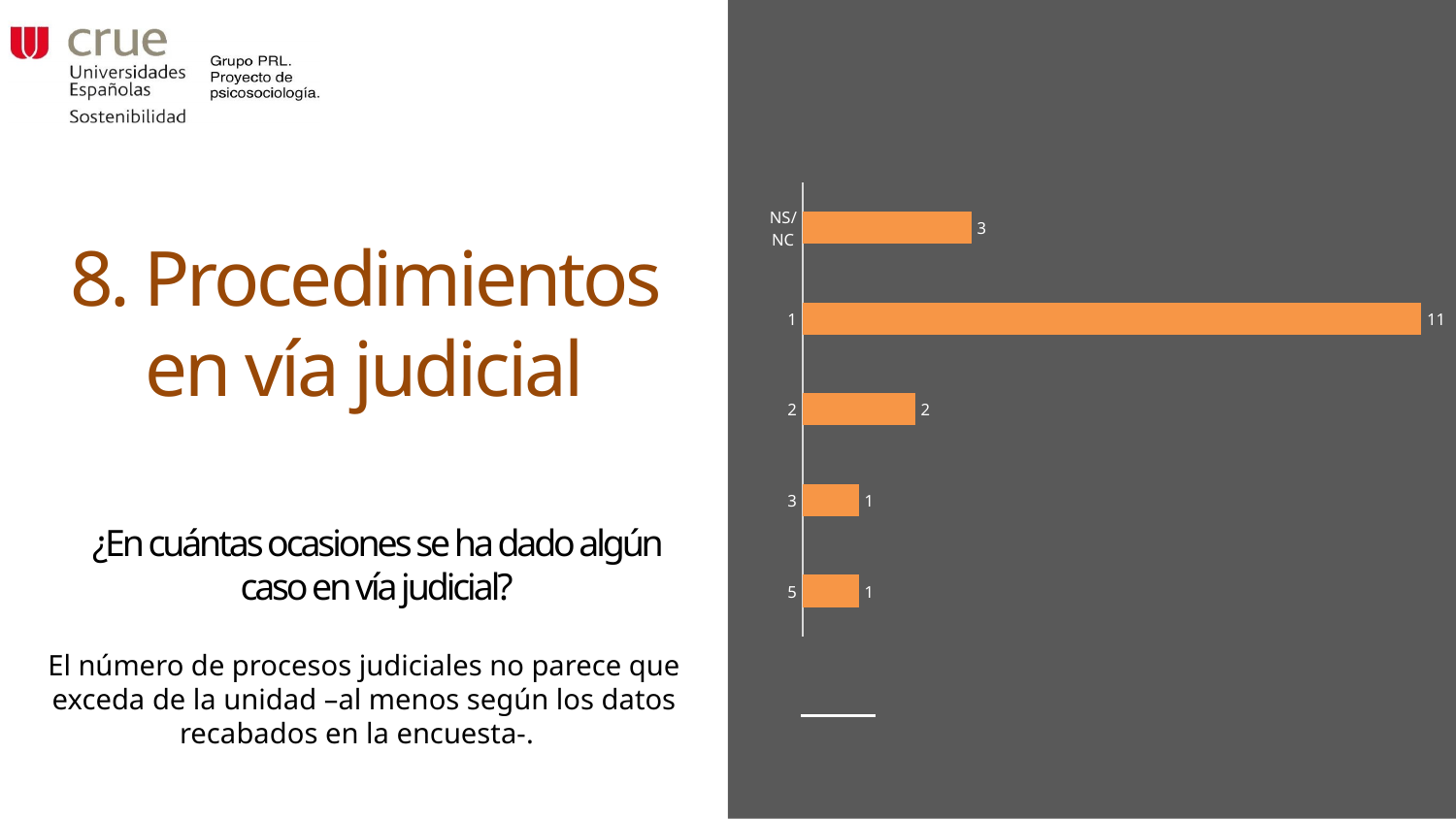
What is the value for the category "NS/NC"? 3 What is the value for the category "1"? 11 How many categories does the chart show? 5 Which category is listed at the top of the chart? NS/NC What is the difference between the values for category "2" and category "3"? 1 Which is larger, the value for "NS/NC" or the value for "2"? NS/NC Which category has the highest value? 1 What is the value for the category "2"? 2 What colour are the bars in the chart? orange What type of chart is shown on the slide? bar chart What is the value for the category "5"? 1 What is the difference between the values for category "1" and category "NS/NC"? 8